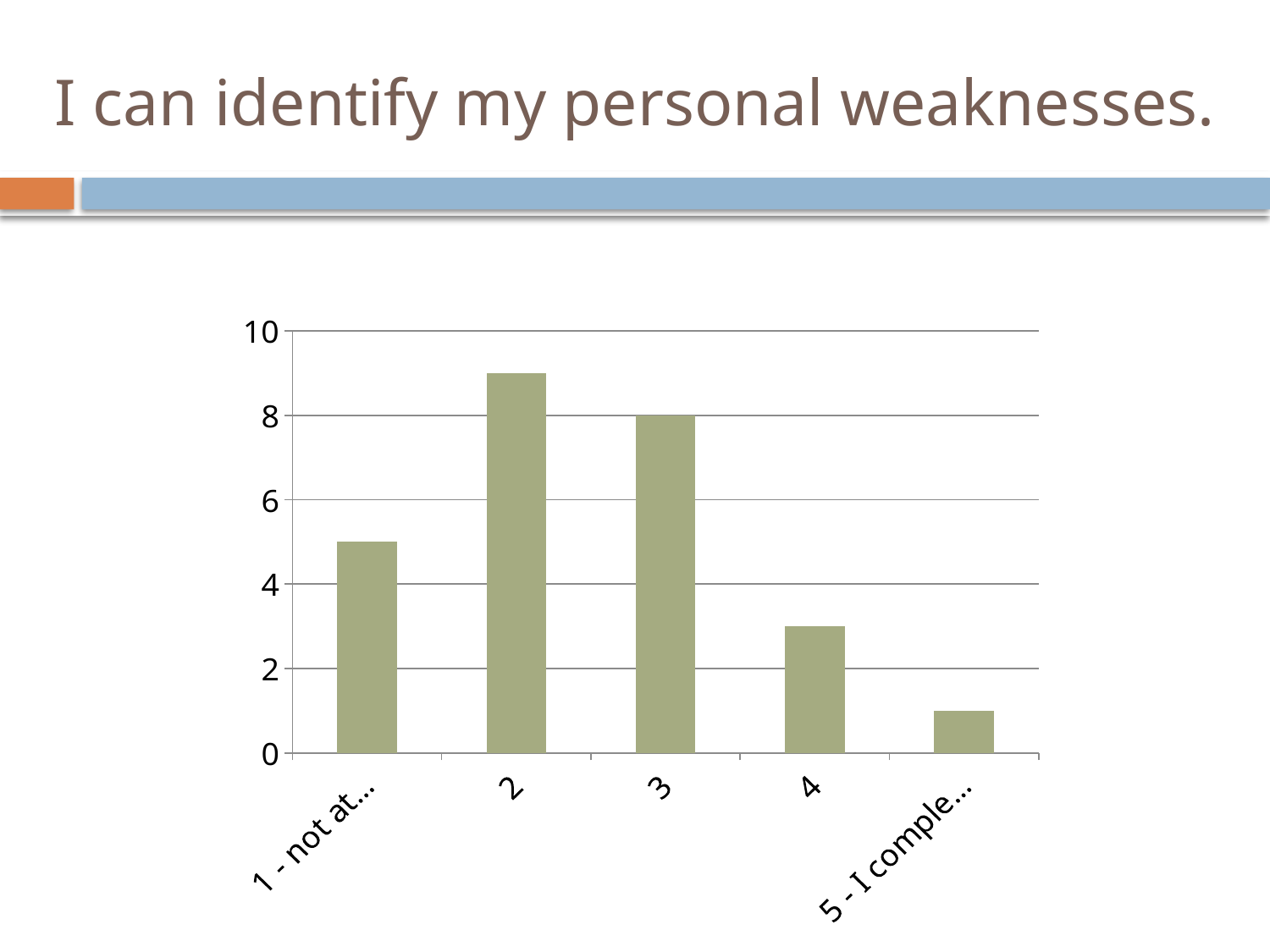
Which is larger, the value for category 2 or category 3? 2 Which category has the highest bar? 2 What kind of chart is shown on the slide? Bar chart Is the value for category 2 greater or less than 8? greater Is the value for the category labelled '5 - I comple...' greater or less than 2? less From category 3 to the category labelled '5 - I comple...', do the values rise or fall? Fall How many categories are shown on the x axis? 5 Is the value for the category labelled '1 - not at...' greater or less than 4? greater Which is larger, the value for category 4 or the category labelled '1 - not at...'? 1 - not at... What is the value for category 3? 8 Which category has the lowest bar? 5 - I comple...